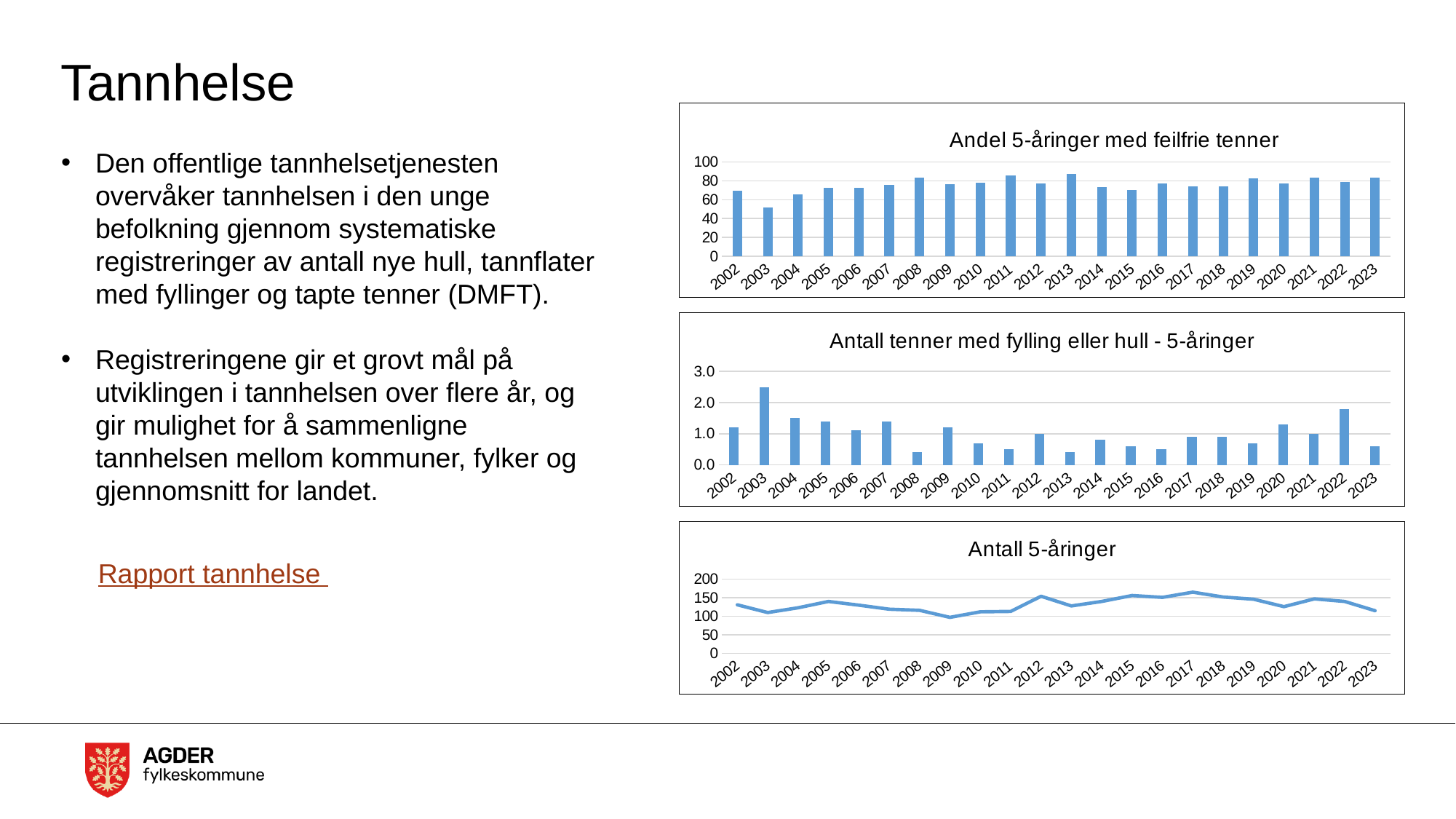
In the chart "Antall tenner med fylling eller hull - 5-åringer", which year has the highest value? 2003 How many years are shown on the x axis of the chart "Antall 5-åringer"? 22 In the chart "Andel 5-åringer med feilfrie tenner", is the value for 2013 greater or less than 80? greater What kind of chart is "Antall 5-åringer"? line chart In the chart "Antall 5-åringer", which year has the lowest value? 2009 In the chart "Antall tenner med fylling eller hull - 5-åringer", is the value for 2008 greater or less than 1.0? less In the chart "Antall tenner med fylling eller hull - 5-åringer", which is larger, the value for 2022 or the value for 2023? 2022 In the chart "Andel 5-åringer med feilfrie tenner", which year has the lowest value? 2003 In the chart "Antall tenner med fylling eller hull - 5-åringer", is the value for 2003 greater or less than 2.0? greater What kind of chart is "Andel 5-åringer med feilfrie tenner"? bar chart